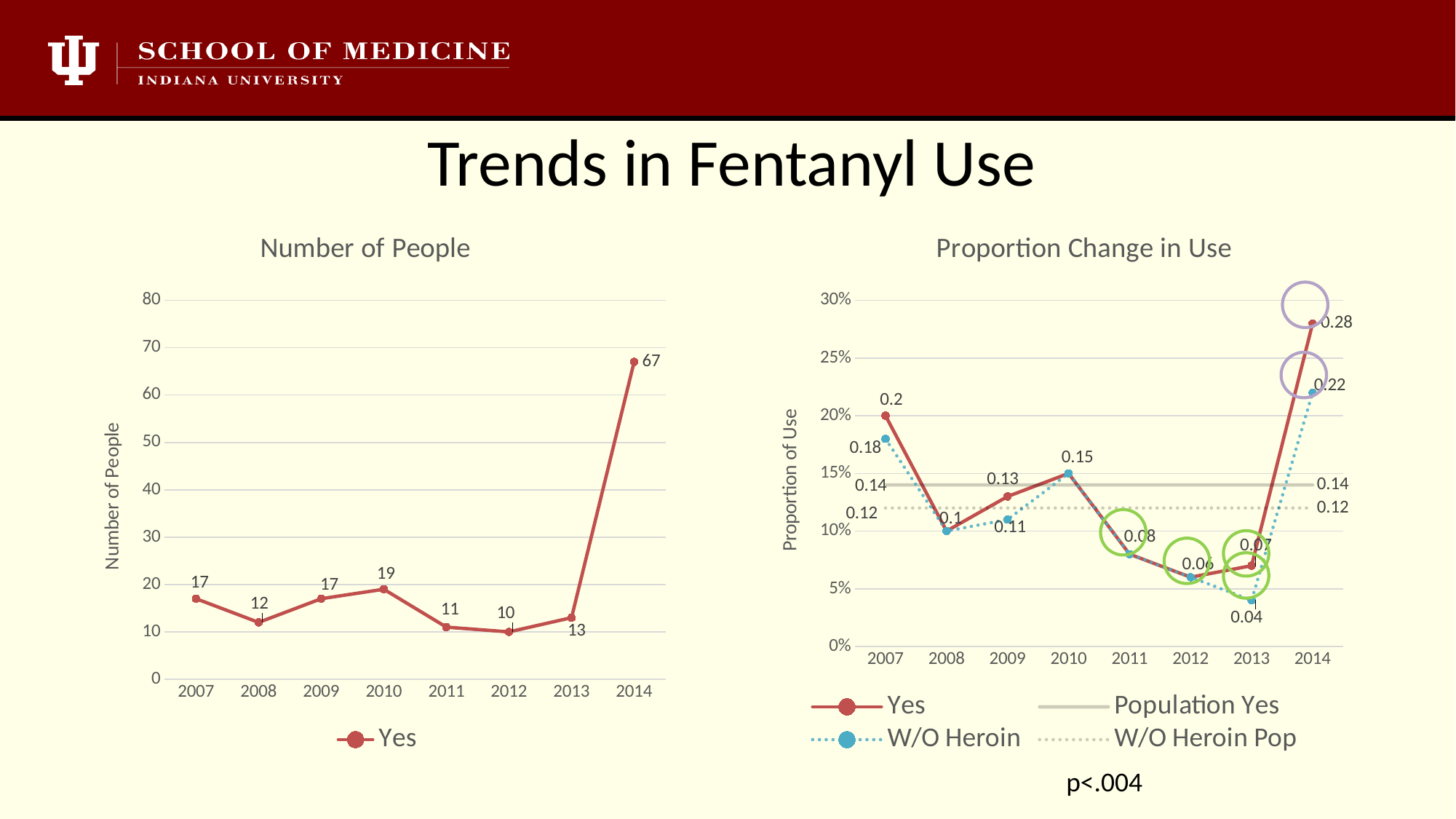
In the 'Proportion Change in Use' chart, what is the value of the 'W/O Heroin' series for 2013? 0.04 What kind of chart is the 'Number of People' chart? Line chart In the 'Number of People' chart, how many years are plotted on the x axis? 8 In the 'Proportion Change in Use' chart, what is the value of the 'Yes' series for 2014? 0.28 In the 'Proportion Change in Use' chart, which is larger for 2014: the 'Yes' series or the 'W/O Heroin' series? Yes In the 'Number of People' chart, which year has the lowest value? 2012 In the 'Number of People' chart, what is the value for 2012? 10 In the 'Proportion Change in Use' chart, how many series does the legend list? 4 In the 'Proportion Change in Use' chart, what is the constant value of the 'Population Yes' line? 0.14 In the 'Number of People' chart, which year has the highest value? 2014 In the 'Number of People' chart, what is the difference between the values for 2014 and 2013? 54 In the 'Number of People' chart, what is the value for 2014? 67